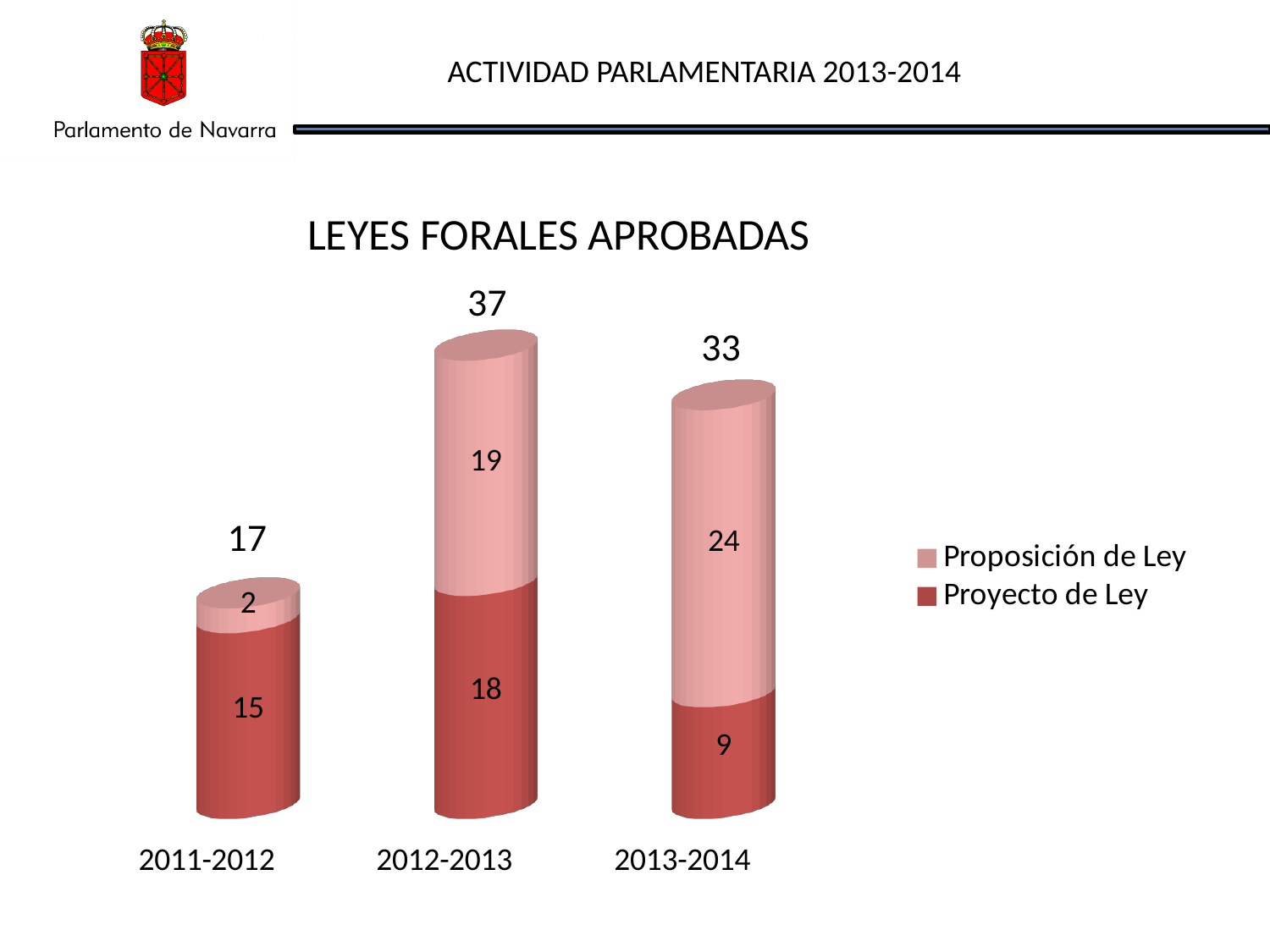
How many periods are shown on the x axis? 3 What is the difference between the Proposición de Ley values for 2013-2014 and 2012-2013? 5 Which period has the highest total of leyes forales aprobadas? 2012-2013 What is the total of the stacked bar for 2012-2013? 37 Which is larger in 2013-2014, Proposición de Ley or Proyecto de Ley? Proposición de Ley What kind of chart is shown? Stacked bar chart What is the value for Proposición de Ley in 2013-2014? 24 Which period has the lowest value for Proyecto de Ley? 2013-2014 What is the value for Proposición de Ley in 2012-2013? 19 What is the total of the stacked bar for 2011-2012? 17 How many series does the legend list? 2 What is the value for Proyecto de Ley in 2011-2012? 15